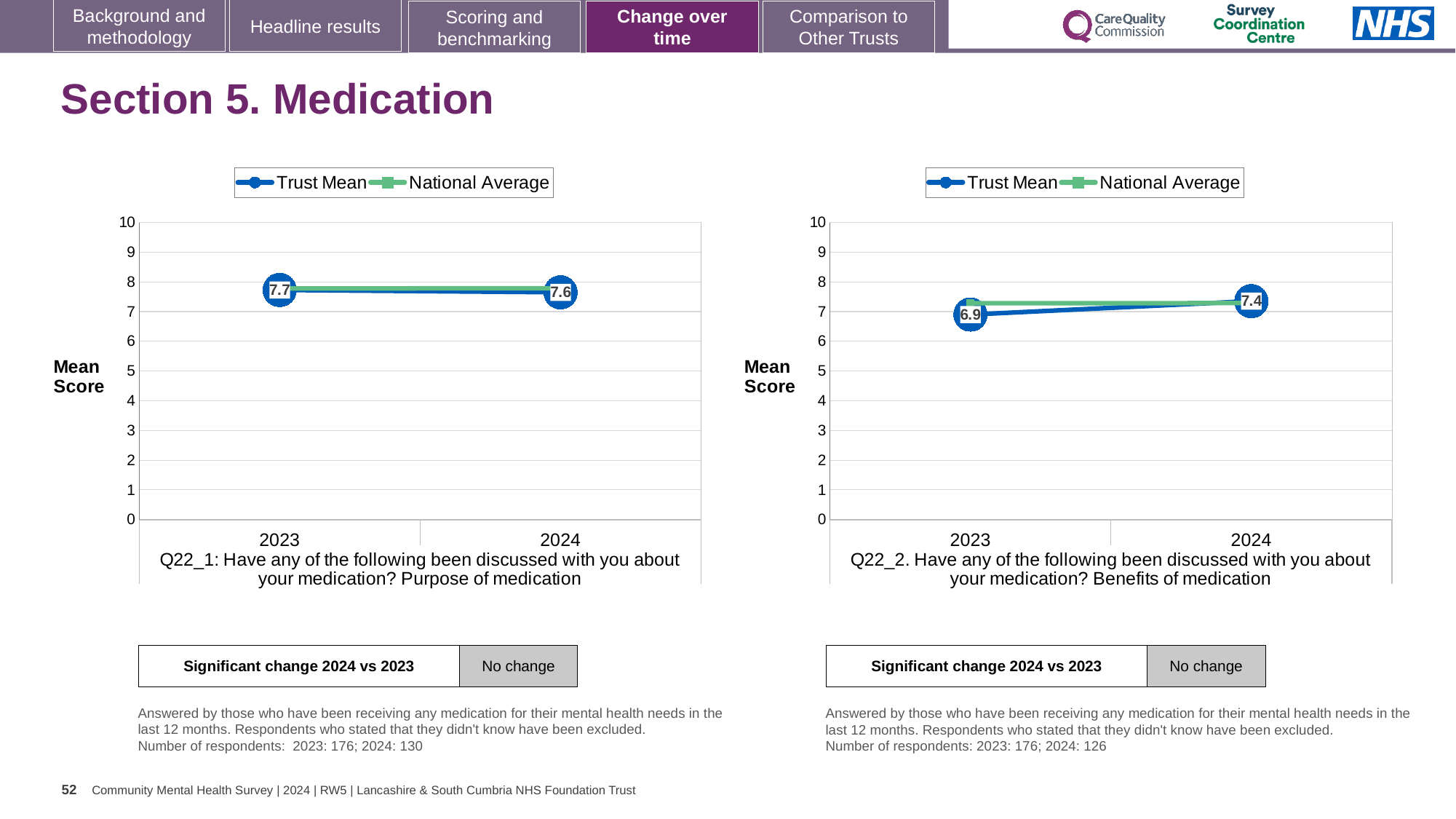
In the Q22_2 chart (right), what is the Trust Mean for 2024? 7.4 How many series does the legend of the Q22_1 chart (left) list? 2 In the Q22_1 chart (left), what is the Trust Mean for 2024? 7.6 In the Q22_2 chart (right), does the Trust Mean rise or fall from 2023 to 2024? rise In the Q22_2 chart (right), what is the Trust Mean for 2023? 6.9 In the Q22_2 chart (right), which year has the higher Trust Mean, 2023 or 2024? 2024 In the Q22_2 chart (right), is the National Average for 2023 greater or less than 6? greater In the Q22_1 chart (left), what is the Trust Mean for 2023? 7.7 In the Q22_1 chart (left), does the Trust Mean rise or fall from 2023 to 2024? fall In the Q22_1 chart (left), what is the difference between the Trust Mean in 2023 and in 2024? 0.1 In the Q22_2 chart (right), by how much did the Trust Mean change from 2023 to 2024? 0.5 What type of chart is the Q22_2 chart (right)? line chart